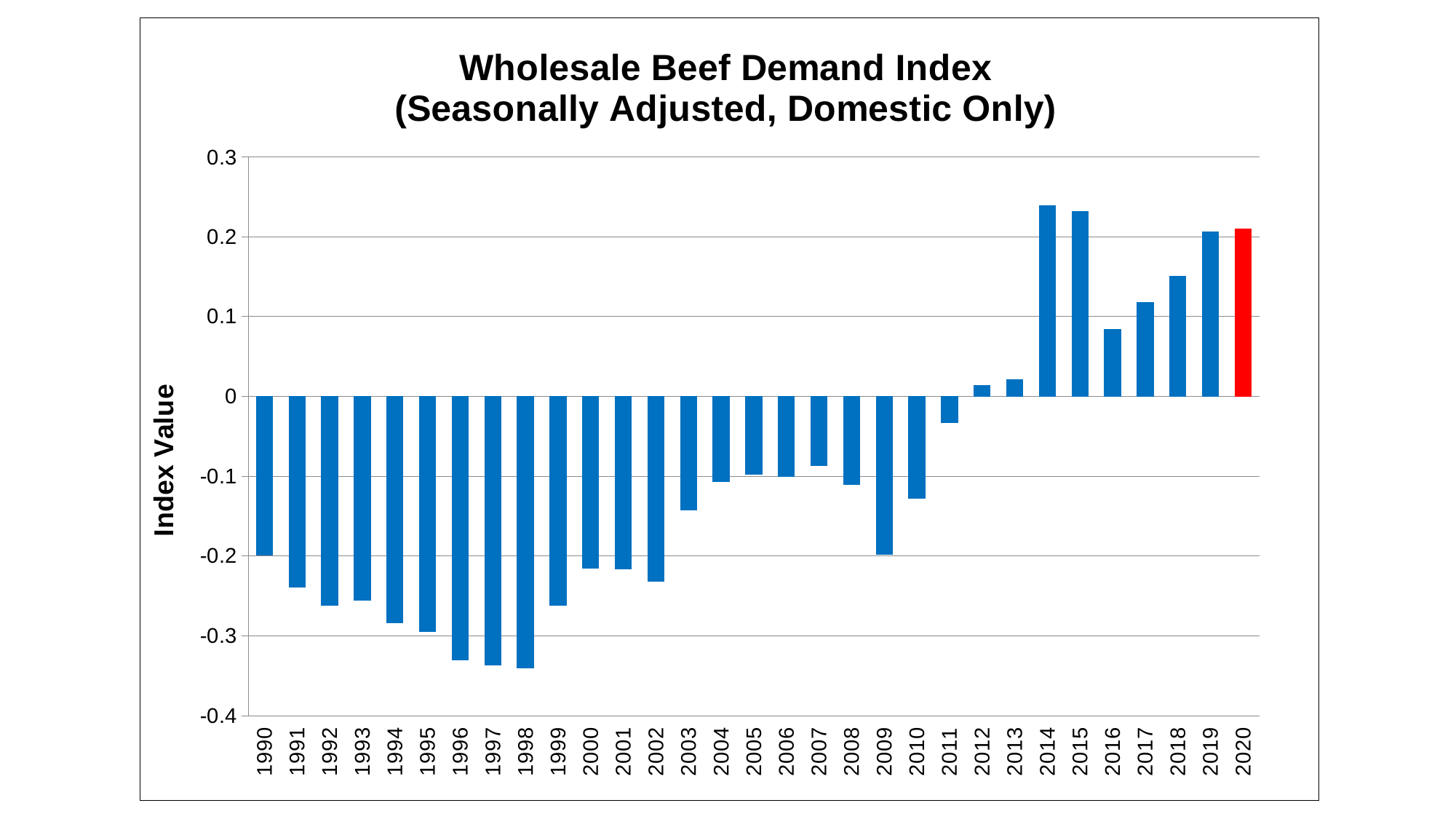
Do the index values rise or fall from 2016 to 2019? rise Is the value for 1996 greater or less than -0.3? less Is the value for 2011 greater or less than 0? less What kind of chart is shown on the slide? bar chart How many years are plotted on the chart? 31 Is the value for 2020 greater or less than 0.2? greater What is the title of the vertical axis? Index Value Which year's bar is coloured red? 2020 Which year has the larger index value, 1995 or 2004? 2004 Which year has the larger index value, 2014 or 2016? 2014